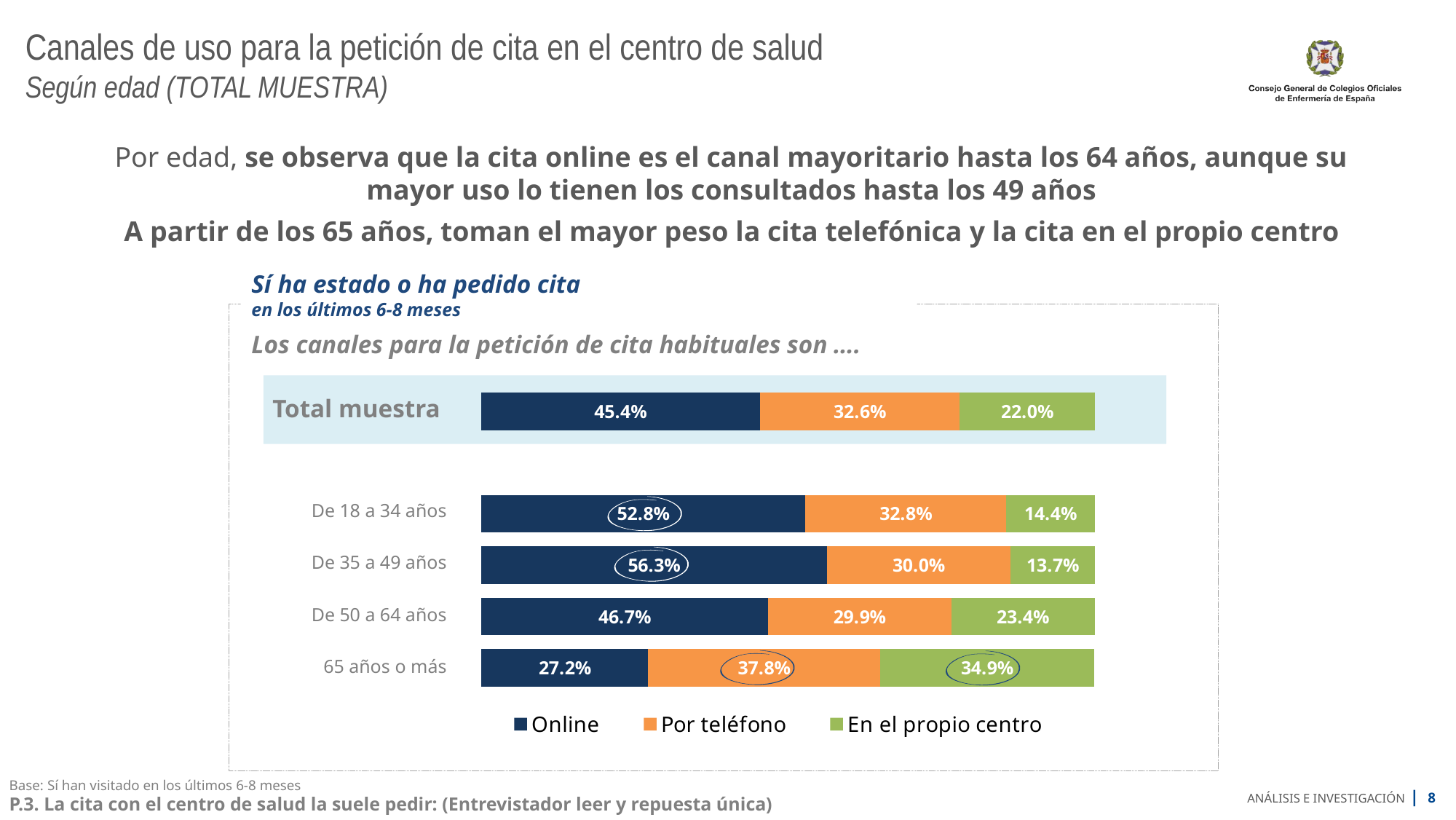
What percentage of respondents aged 18 to 34 (De 18 a 34 años) request appointments online? 52.8% Which colour represents 'En el propio centro' in the legend? Green How many series does the legend list? 3 For the De 50 a 64 años group, which is larger: 'Online' or 'Por teléfono'? Online Which age group has the lowest 'En el propio centro' percentage? De 35 a 49 años How many age groups are shown below the Total muestra bar? 4 What is the 'En el propio centro' value for the Total muestra bar? 22.0% What kind of chart is shown on the slide? Stacked bar chart For the 65 años o más group, what is the difference between the 'Por teléfono' and 'Online' percentages? 10.6% What is the 'Por teléfono' value for the 65 años o más group? 37.8% What is the total of the three segments in the De 18 a 34 años bar? 100.0% Which age group has the highest 'Online' percentage? De 35 a 49 años